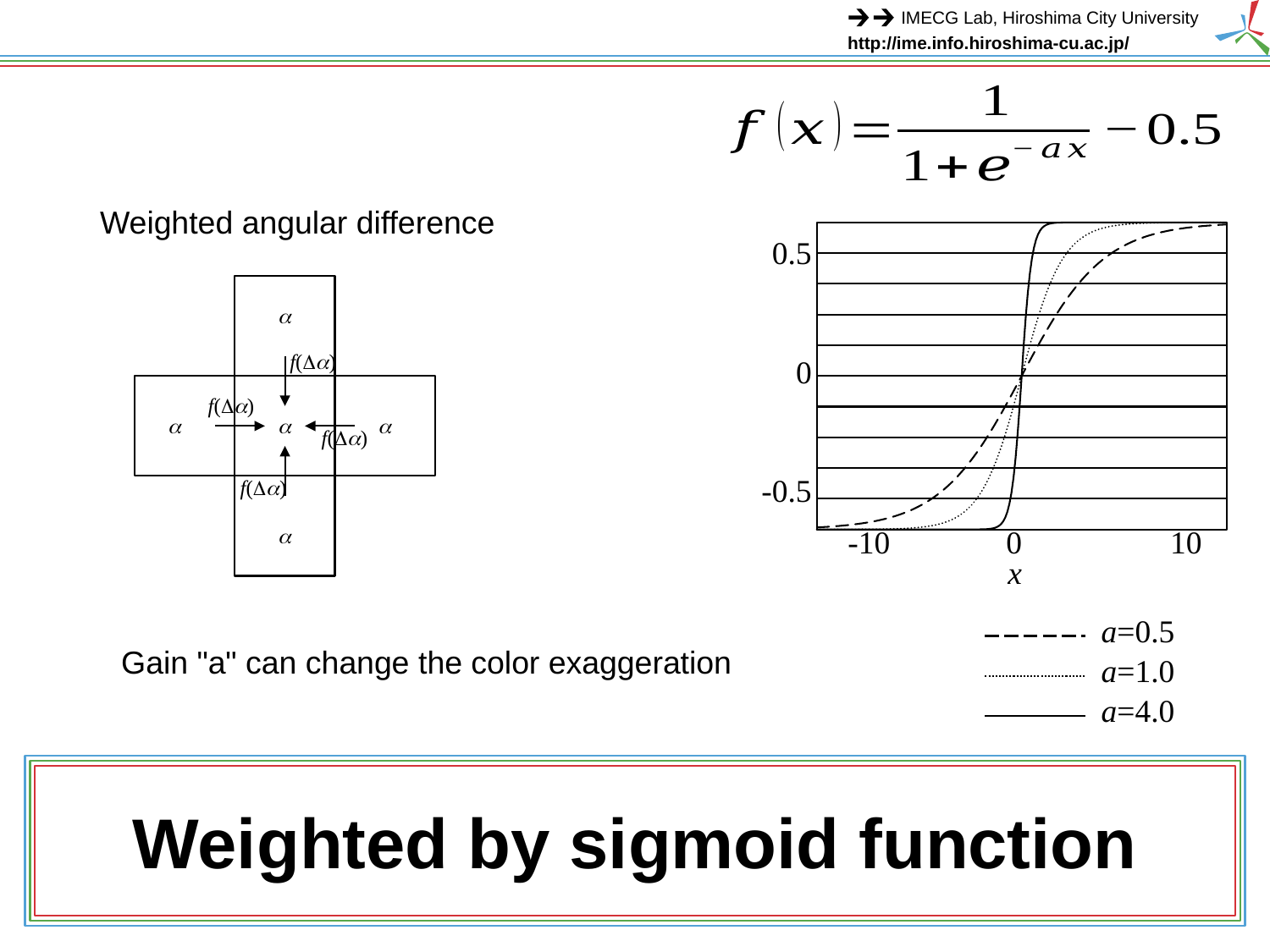
Is the value of the a=0.5 curve at x=-10 greater or less than 0? less Which values of a are listed in the chart's legend? a=0.5, a=1.0, a=4.0 What is the value of the curves at x=0 in the chart? 0 Which curve reaches 0.5 fastest as x increases from 0? a=4.0 Is the value of the a=4.0 curve at x=5 greater or less than 0? greater Do the curves in the chart rise or fall as x increases from -10 to 10? rise Is the value of the a=1.0 curve at x=-2 greater or less than 0? less At x=-5, which curve has the larger value, a=0.5 or a=4.0? a=0.5 How many series does the legend of the chart list? 3 At x=5, which curve has the larger value, a=4.0 or a=0.5? a=4.0 Which line style represents a=4.0 in the chart? solid line What kind of chart is shown on the right side of the slide? line chart